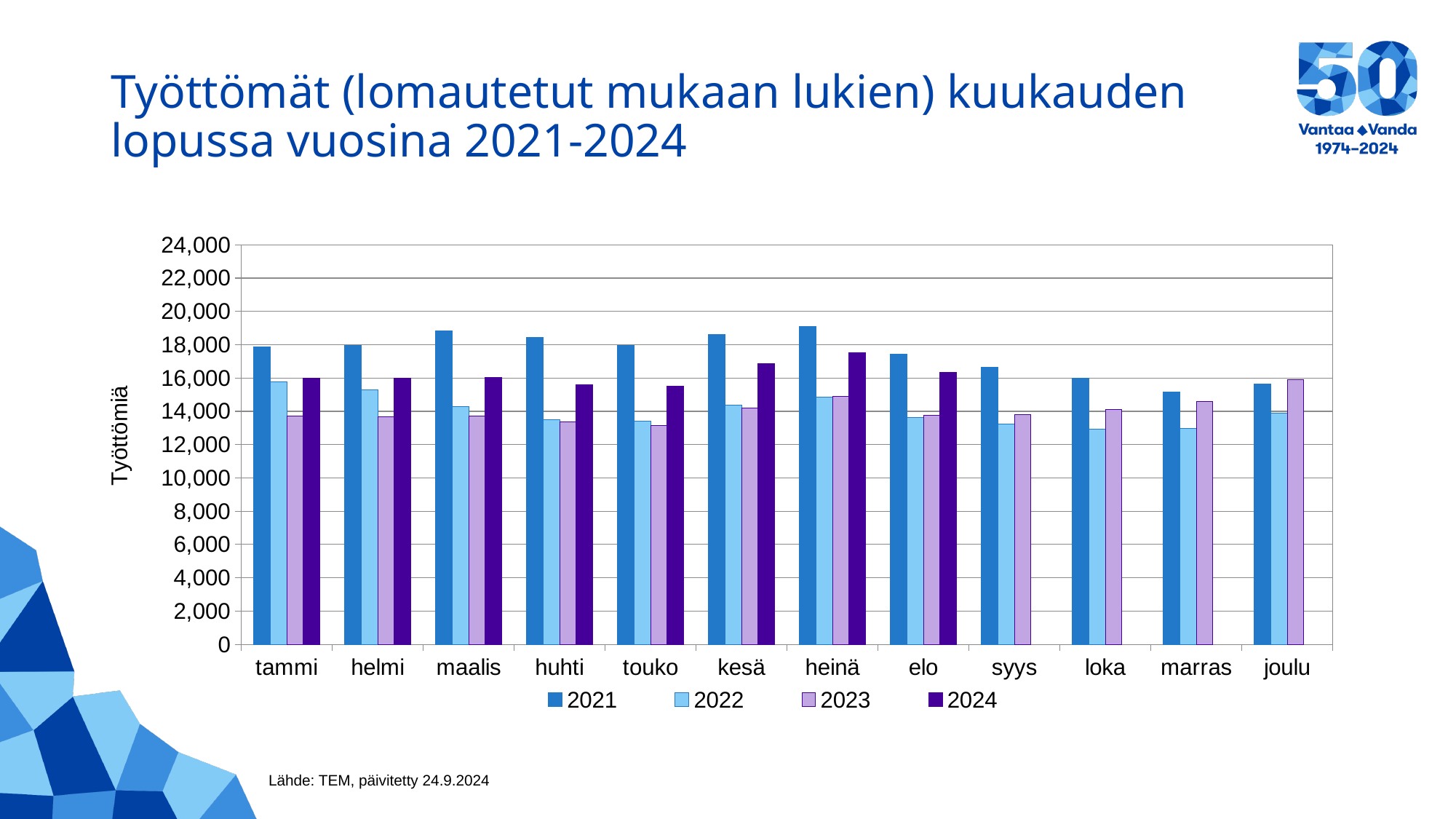
What kind of chart is shown on the slide? bar chart In which month is the 2021 value lowest? marras Is the 2022 value for loka greater or less than 14,000? less For how many months is a 2024 bar plotted? 8 In which month is the 2021 value highest? heinä In which month is the 2024 value highest? heinä How many months are shown on the x axis? 12 Do the 2021 values rise or fall from elo to marras? fall Is the 2021 value for heinä greater or less than 18,000? greater Which is larger for tammi, the 2021 value or the 2024 value? 2021 How many series does the legend list? 4 What is the label on the vertical axis? Työttömiä